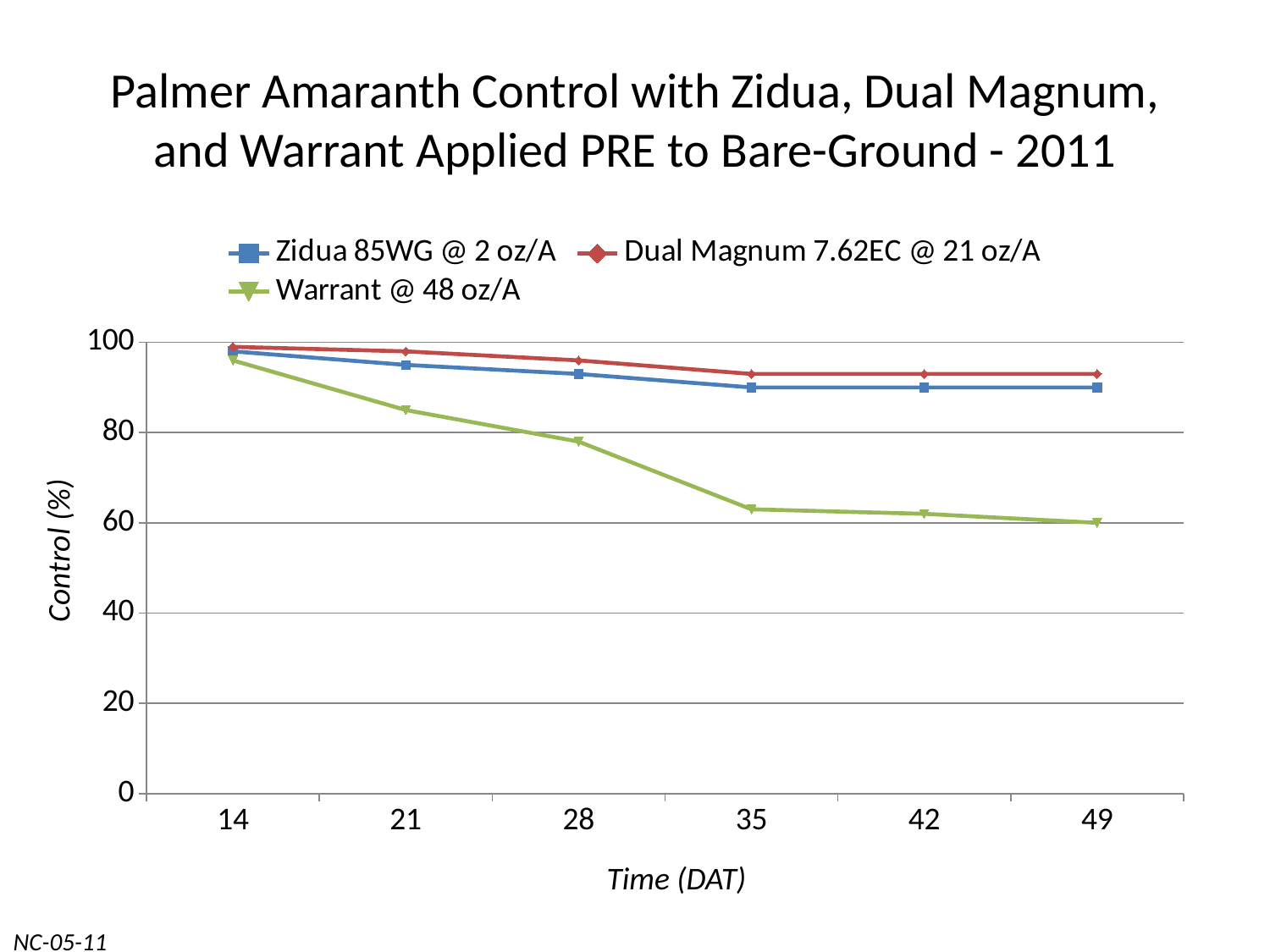
How many time points (DAT) are plotted along the x axis? 6 Which series has the lowest control value at 49 DAT? Warrant @ 48 oz/A What kind of chart is shown on the slide? line chart Is the control value for Zidua 85WG @ 2 oz/A at 49 DAT greater or less than 80? greater At 35 DAT, which is larger: the control value for Dual Magnum 7.62EC @ 21 oz/A or for Warrant @ 48 oz/A? Dual Magnum 7.62EC @ 21 oz/A How many series does the legend list? 3 Is the control value for Warrant @ 48 oz/A at 35 DAT greater or less than 80? less Is the control value for Warrant @ 48 oz/A at 21 DAT greater or less than 80? greater What is the label on the y axis? Control (%) What is the label on the x axis? Time (DAT) Which series has the highest control value at 35 DAT? Dual Magnum 7.62EC @ 21 oz/A Does the control value for Warrant @ 48 oz/A rise or fall from 14 DAT to 49 DAT? fall